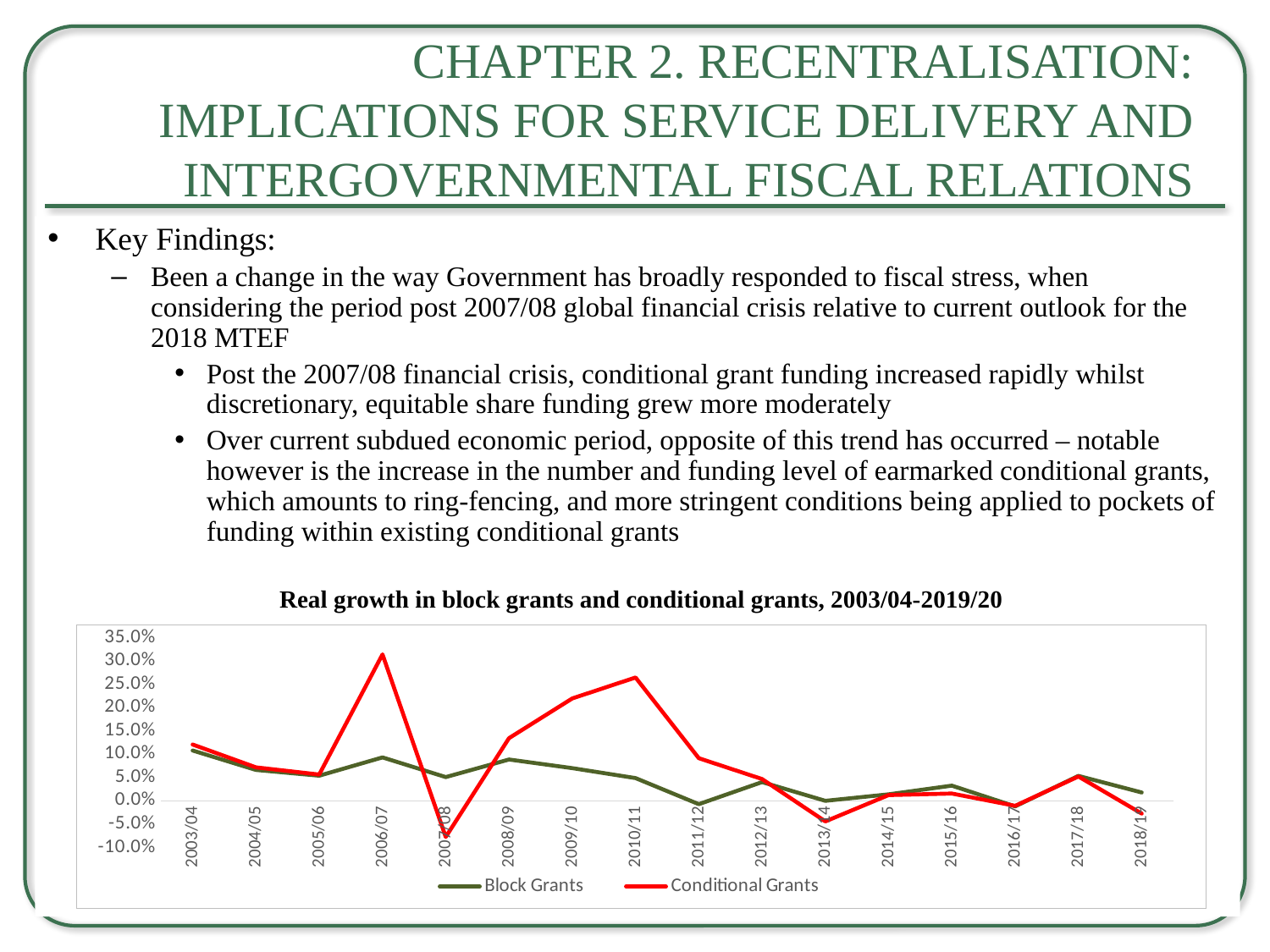
In which year does the Conditional Grants series reach its lowest value? 2007/08 How many financial years are plotted along the x axis? 16 Is the value for Conditional Grants in 2006/07 greater or less than 25.0%? greater What is the title of the chart? Real growth in block grants and conditional grants, 2003/04-2019/20 Which series has the larger value in 2007/08, Block Grants or Conditional Grants? Block Grants Which series has the larger value in 2006/07, Block Grants or Conditional Grants? Conditional Grants In which year does the Conditional Grants series reach its highest value? 2006/07 What kind of chart is shown on the slide? Line chart Does the Conditional Grants series rise or fall between 2010/11 and 2013/14? Fall Is the value for Conditional Grants in 2010/11 greater or less than 20.0%? greater Is the value for Conditional Grants in 2007/08 greater or less than -5.0%? less How many series does the legend list? 2